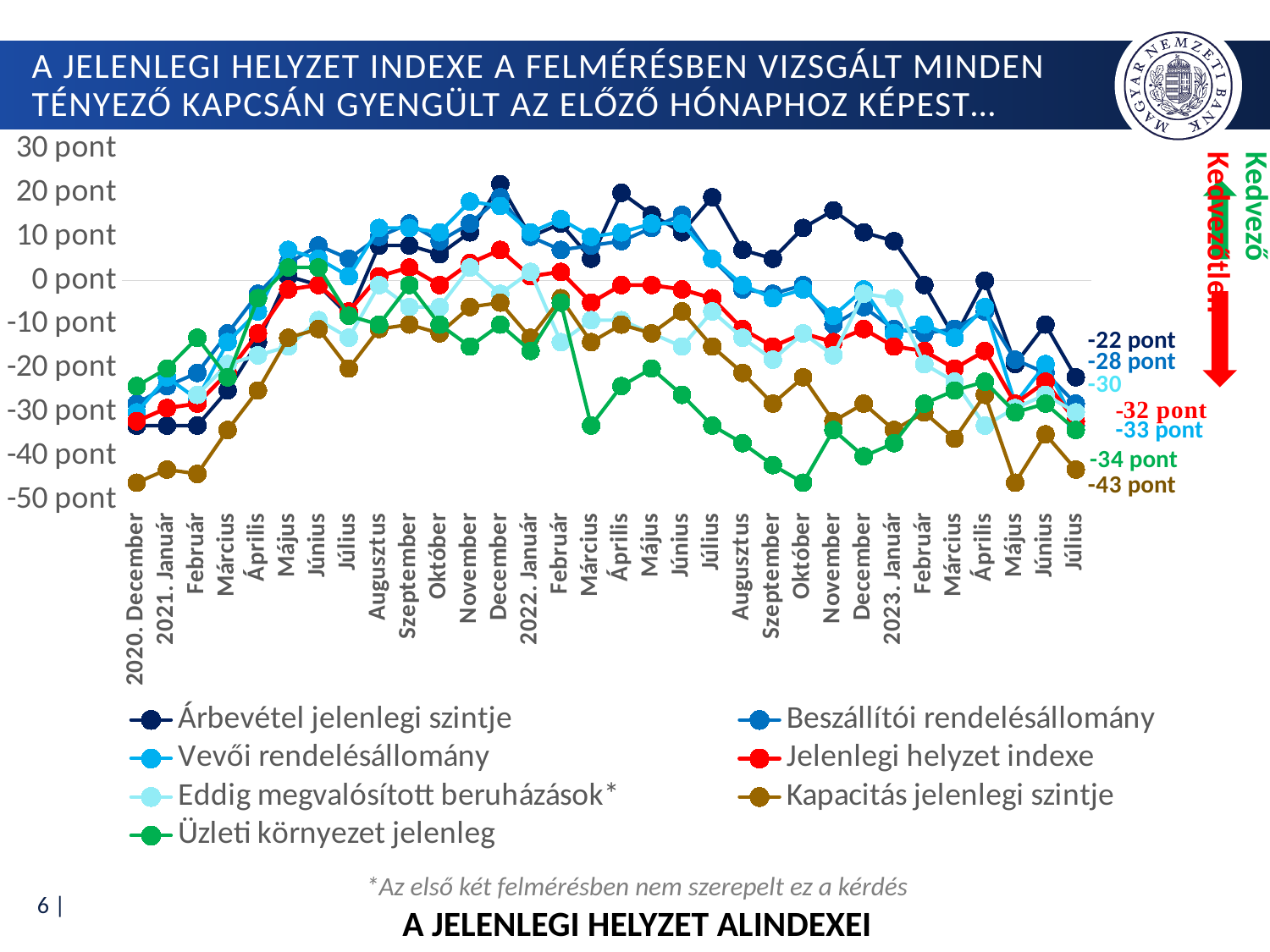
What is the difference between the 2023 Július values of Árbevétel jelenlegi szintje and Kapacitás jelenlegi szintje? 21 pont What is the value of Kapacitás jelenlegi szintje in 2023 Július? -43 pont Which series has the lowest value in 2023 Július? Kapacitás jelenlegi szintje In 2023 Július, which is larger: Beszállítói rendelésállomány or Eddig megvalósított beruházások? Beszállítói rendelésállomány What kind of chart is shown on the slide? Line chart What is the value of Árbevétel jelenlegi szintje in 2023 Július? -22 pont What is the value of Üzleti környezet jelenleg in 2023 Július? -34 pont Is the value for Kapacitás jelenlegi szintje in 2020 December greater or less than -40 pont? less Which series has the highest value in 2023 Július? Árbevétel jelenlegi szintje How many series does the legend list? 7 What is the value of Jelenlegi helyzet indexe in 2023 Július? -32 pont